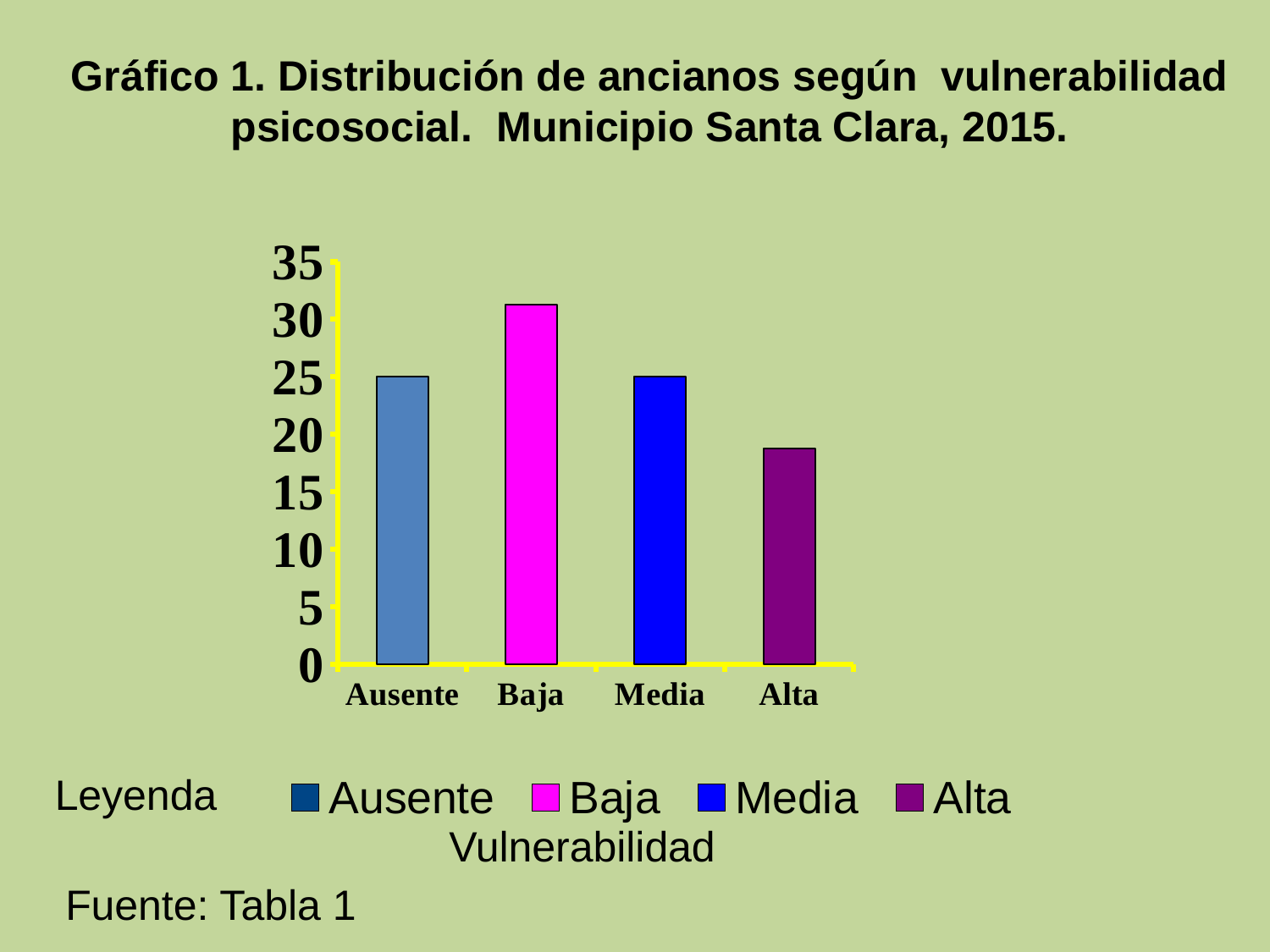
Which vulnerability category has the lowest bar? Alta How many vulnerability categories are plotted on the x axis? 4 How many entries does the legend list? 4 What kind of chart is shown on the slide? bar chart Which is larger, the value for Baja or the value for Alta? Baja Is the value for Alta greater or less than 15? greater Which vulnerability category has the highest bar? Baja What colour is the bar for Baja? magenta Is the value for Baja greater or less than 30? greater Is the value for Alta greater or less than 20? less What is the title of the chart? Gráfico 1. Distribución de ancianos según vulnerabilidad psicosocial. Municipio Santa Clara, 2015. Which is larger, the value for Ausente or the value for Alta? Ausente